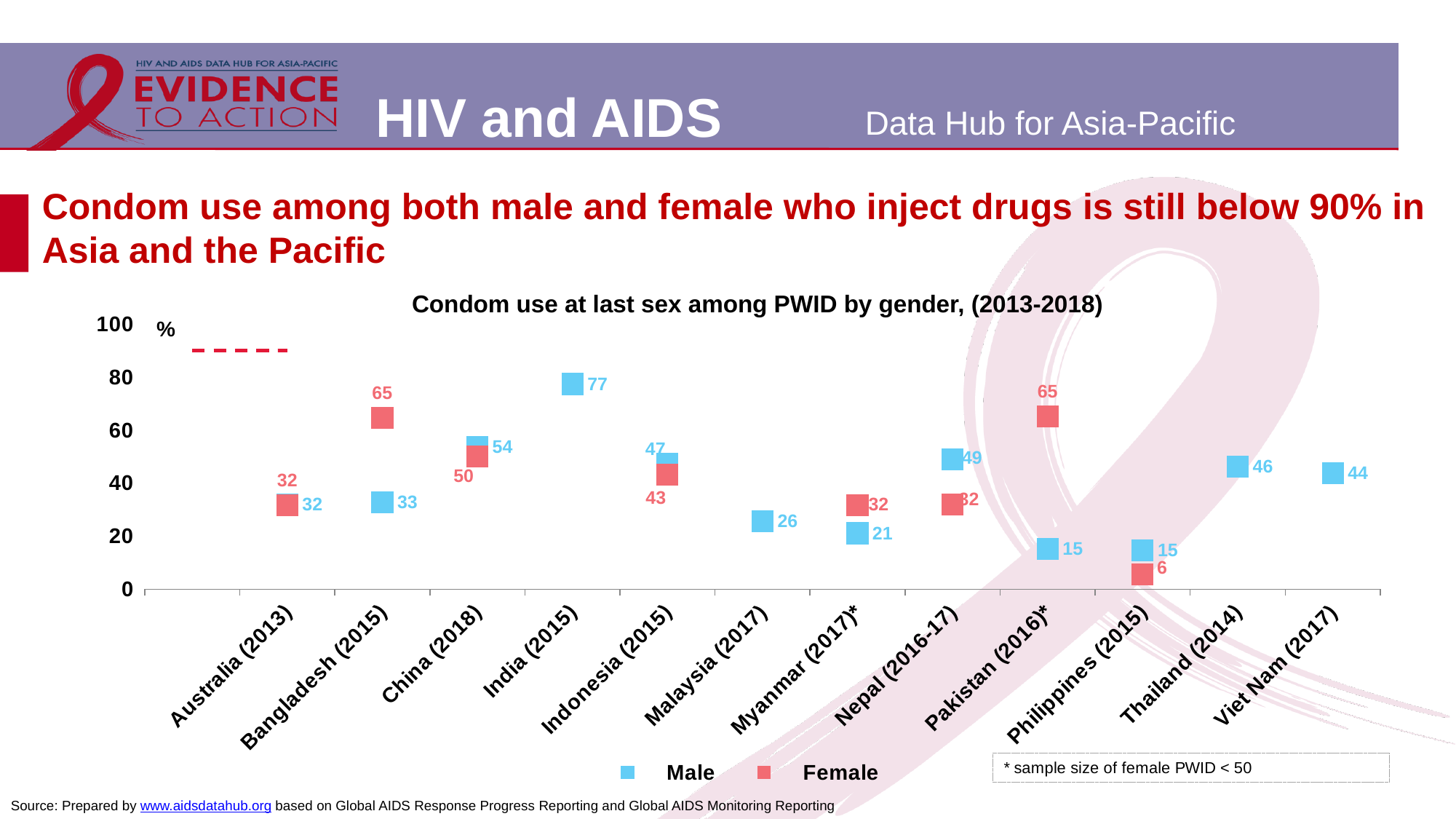
What is the Male value for Viet Nam (2017)? 44 What kind of chart is this? Scatter (dot) chart What is the Female value for Philippines (2015)? 6 What is the Female value for Bangladesh (2015)? 65 How many countries are shown on the x axis? 12 Which country has the lowest Female value? Philippines (2015) What is the Male value for India (2015)? 77 What is the difference between the Female and Male values for Pakistan (2016)*? 50 How many series does the legend list? 2 Which country has the highest Male value? India (2015) For Bangladesh (2015), which is larger, the Male or the Female value? Female What colour are the Male markers in the chart? Blue